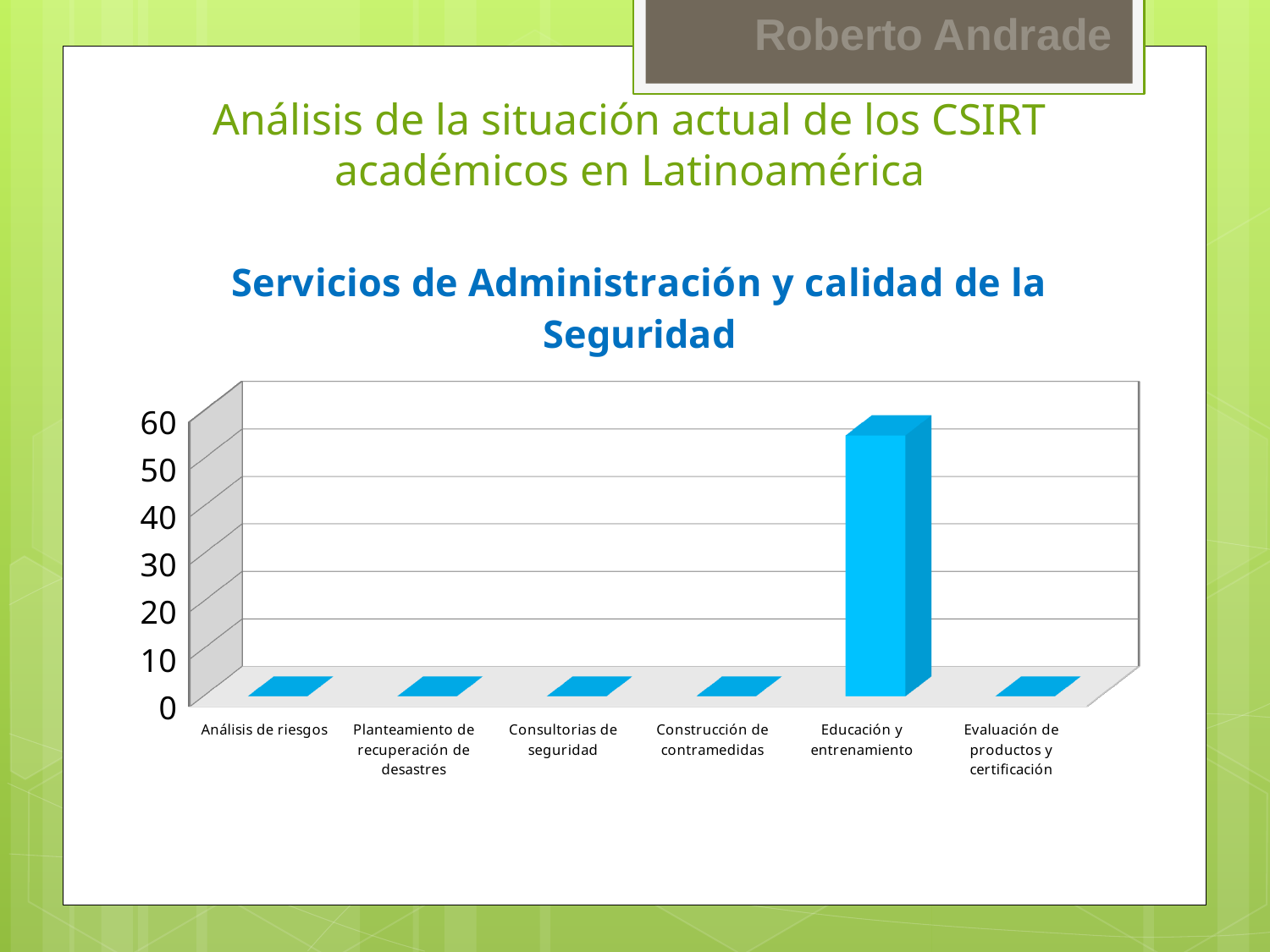
How many categories are shown on the x axis of the chart? 6 Which category has the highest value in the chart? Educación y entrenamiento What is the value for Análisis de riesgos? 0 What kind of chart is shown on the slide? bar chart Which is larger, the value for Educación y entrenamiento or the value for Análisis de riesgos? Educación y entrenamiento Is the value for Educación y entrenamiento greater or less than 50? greater What is the highest value shown on the vertical axis of the chart? 60 What is the title of the chart? Servicios de Administración y calidad de la Seguridad What is the value for Construcción de contramedidas? 0 Is the value for Consultorias de seguridad greater or less than 10? less Is the value for Educación y entrenamiento greater or less than 60? less